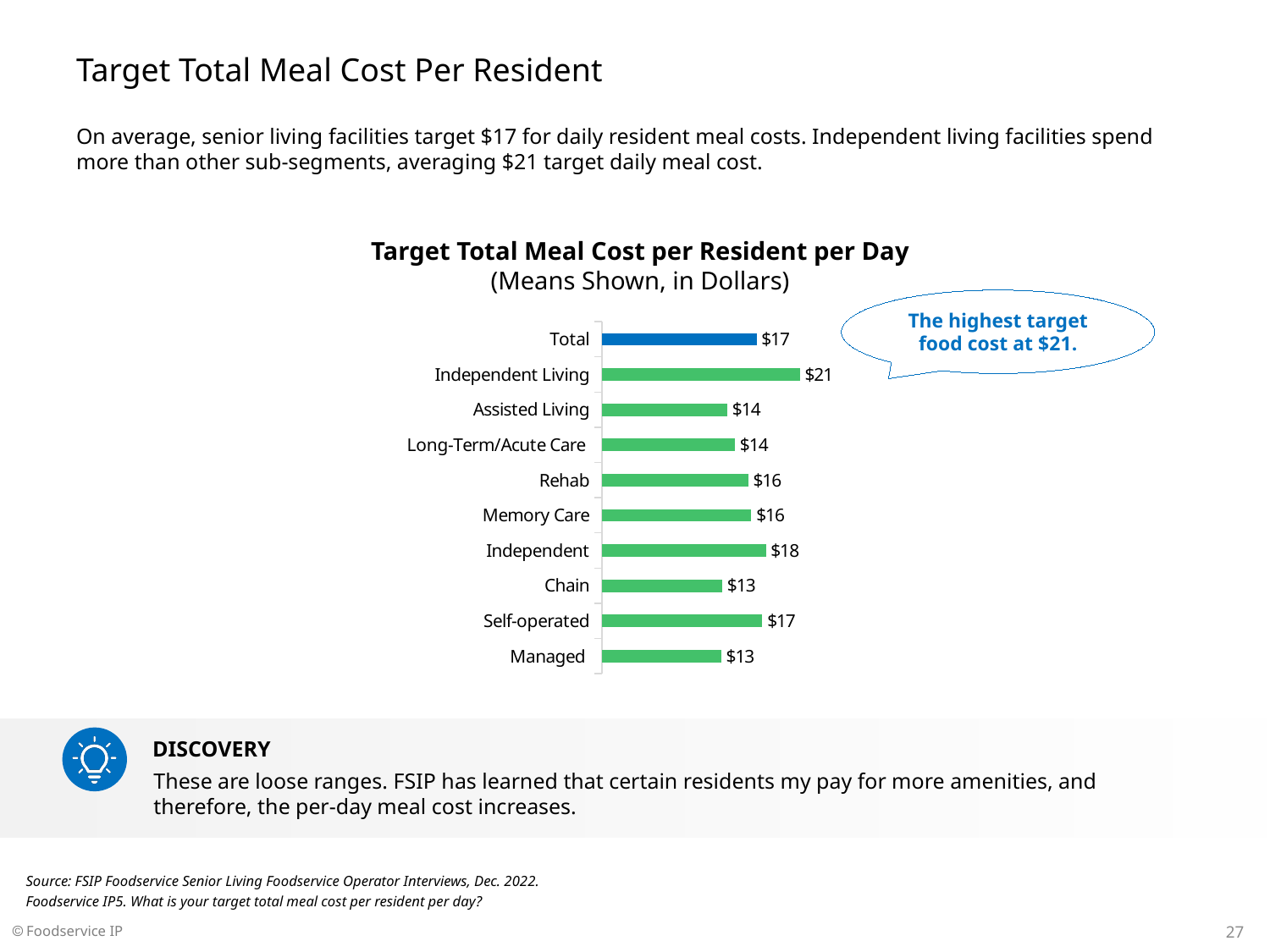
What kind of chart is shown on the slide? Bar chart What is the value shown for Self-operated? $17 What is the target total meal cost per resident per day for Independent Living? $21 Which category has the highest target total meal cost per resident per day? Independent Living What is the title of the chart? Target Total Meal Cost per Resident per Day What is the target total meal cost per resident per day for Chain facilities? $13 What is the difference between the Rehab value and the Chain value? $3 Which is larger, the value for Independent or the value for Memory Care? Independent What is the value shown for Long-Term/Acute Care? $14 Which bar is shown in a different colour (blue) from the others? Total What is the difference between the Independent Living value and the Total value? $4 How many categories are plotted in the chart? 10